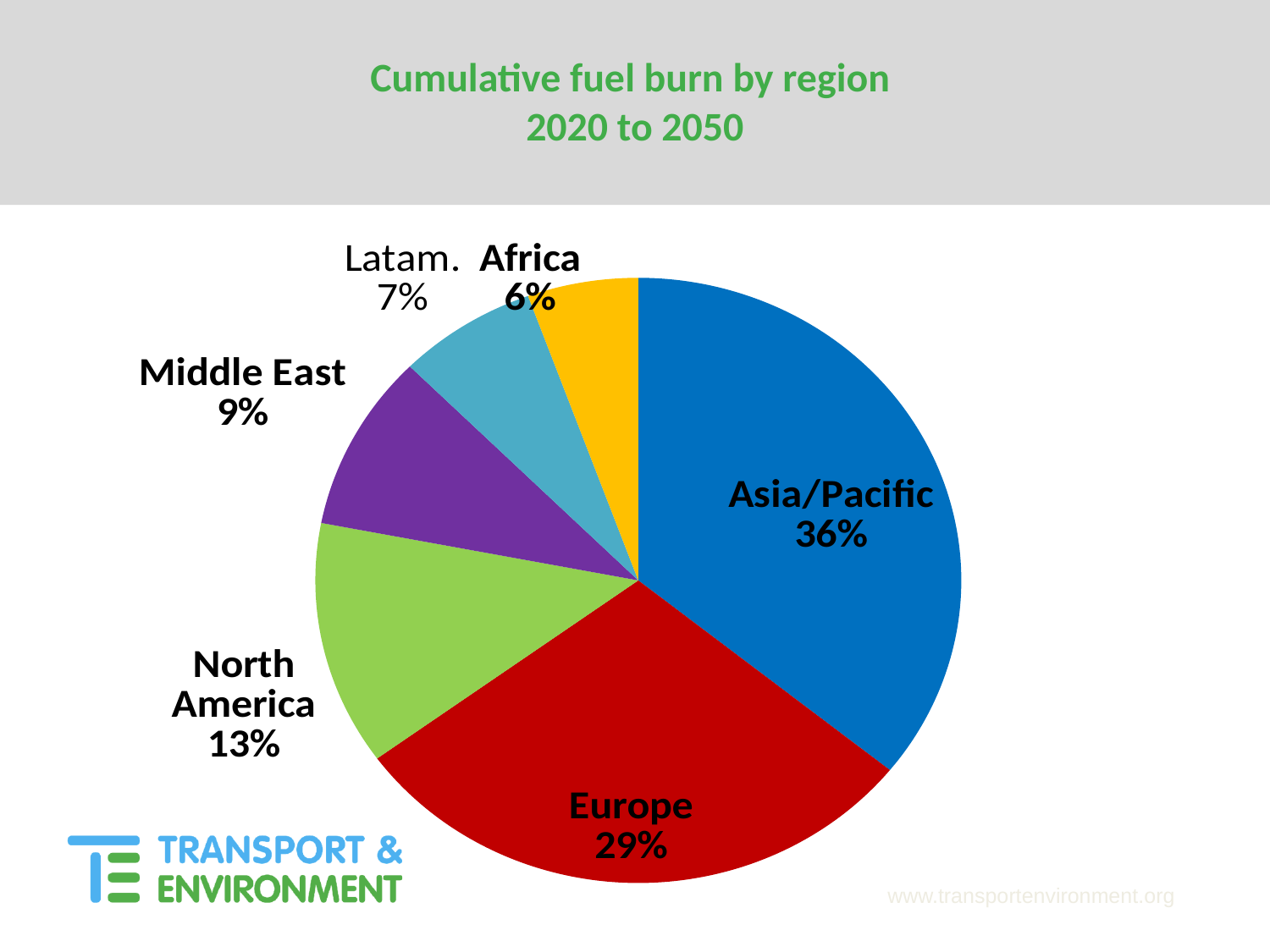
What type of chart is shown on the slide? Pie chart How many percentage points larger is Asia/Pacific's share than Europe's? 7 What share of cumulative fuel burn does Asia/Pacific account for? 36% How many regions are shown in the pie chart? 6 What share of cumulative fuel burn does North America account for? 13% What share of cumulative fuel burn does the Middle East account for? 9% Which region has the largest share of cumulative fuel burn? Asia/Pacific Which region has the smallest share of cumulative fuel burn? Africa What share of cumulative fuel burn does Africa account for? 6% Which has a larger share of cumulative fuel burn, North America or the Middle East? North America What share of cumulative fuel burn does Europe account for? 29% What is the title of the chart? Cumulative fuel burn by region 2020 to 2050